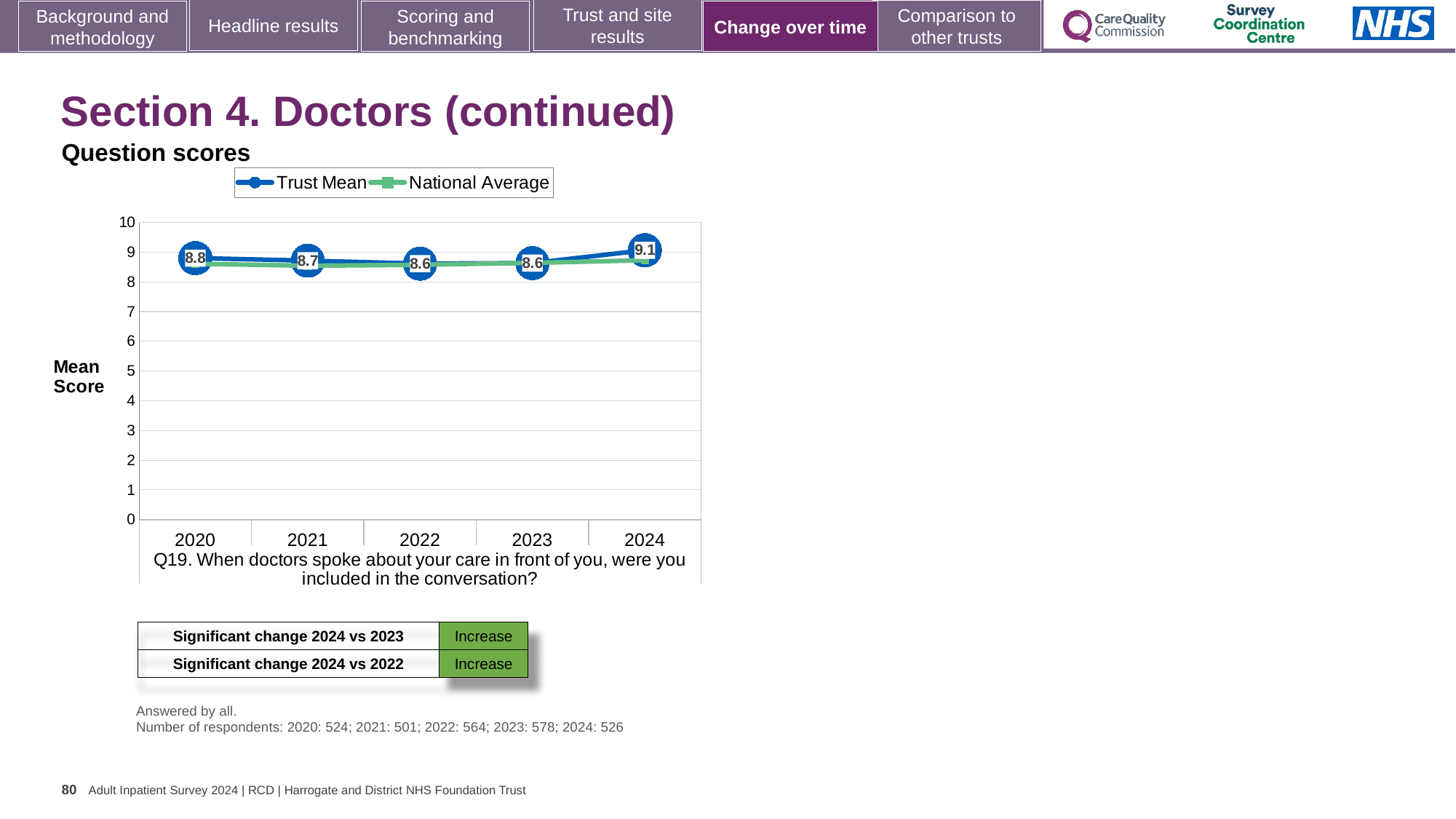
How many series does the legend list? 2 What is the Trust Mean score for 2023? 8.6 What is the Trust Mean score for 2021? 8.7 Is the National Average value for 2024 greater or less than 8? greater What is the Trust Mean score for 2024? 9.1 Which is larger, the Trust Mean score for 2020 or for 2022? 2020 How many years are plotted on the x axis? 5 What is the Trust Mean score for 2020? 8.8 What is the difference between the Trust Mean scores for 2024 and 2020? 0.3 What is the difference between the Trust Mean scores for 2024 and 2023? 0.5 What kind of chart is shown on the slide? line chart In which year is the Trust Mean score highest? 2024